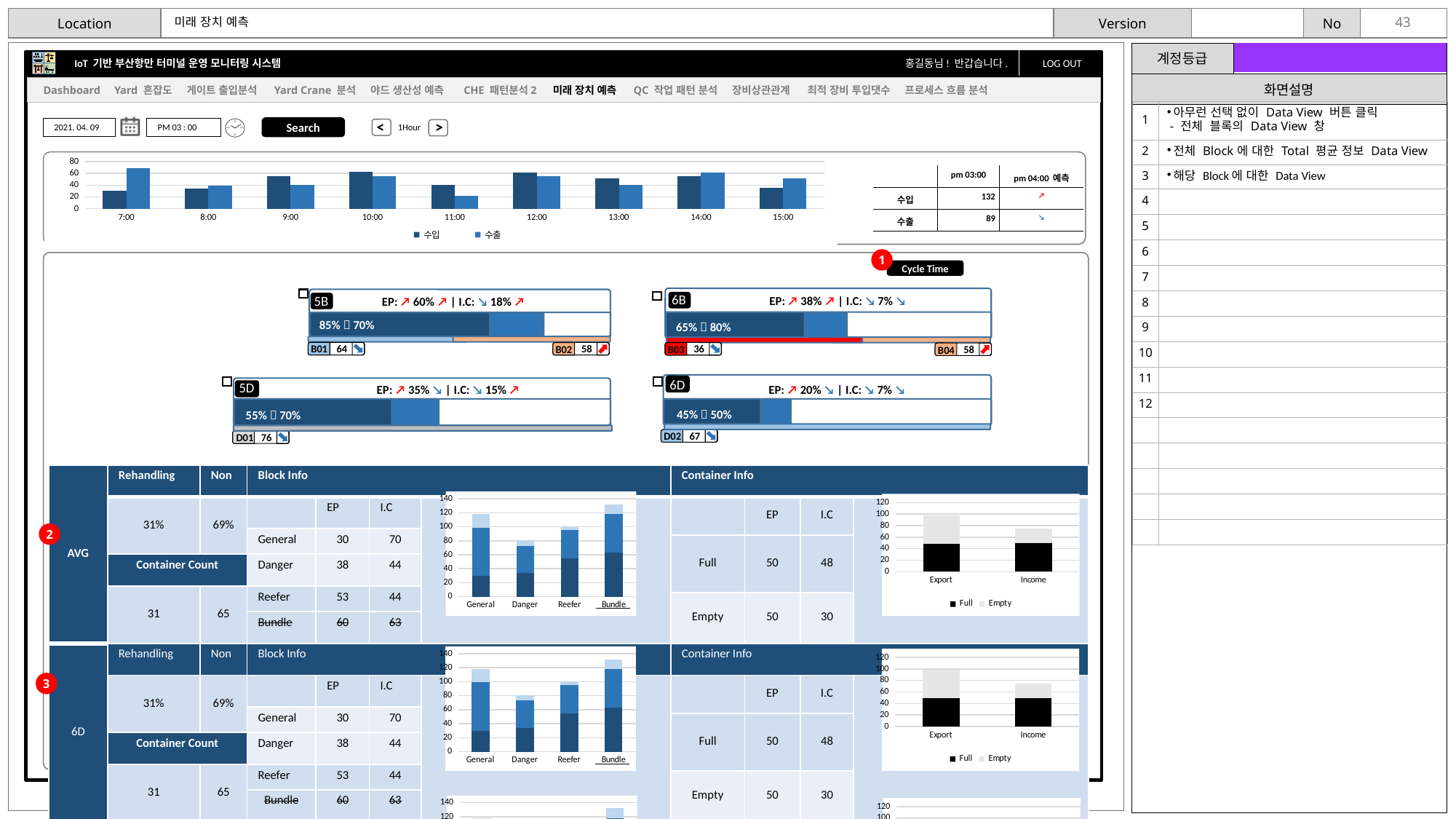
In the Block Info stacked bar chart of the AVG row, which category has the tallest stacked bar? Bundle In the top hourly chart, is the 수입 value at 7:00 greater or less than 40? less In the top hourly chart, at which time is the 수출 bar highest? 7:00 In the Container Info chart of the AVG row, which category has the taller stacked bar, Export or Income? Export What are the two legend entries of the top hourly chart? 수입, 수출 In the Block Info stacked bar chart of the AVG row, how many categories are on the x axis? 4 How many time categories are shown on the x axis of the top hourly chart? 9 In the top hourly chart, at which time is the 수출 bar lowest? 11:00 In the top hourly chart, at 11:00, which series has the larger bar, 수입 or 수출? 수입 How many series does the legend of the top hourly chart list? 2 In the Block Info stacked bar chart of the AVG row, is the total for Danger greater or less than 100? less What kind of chart is the hourly chart at the top of the slide (7:00 to 15:00)? bar chart